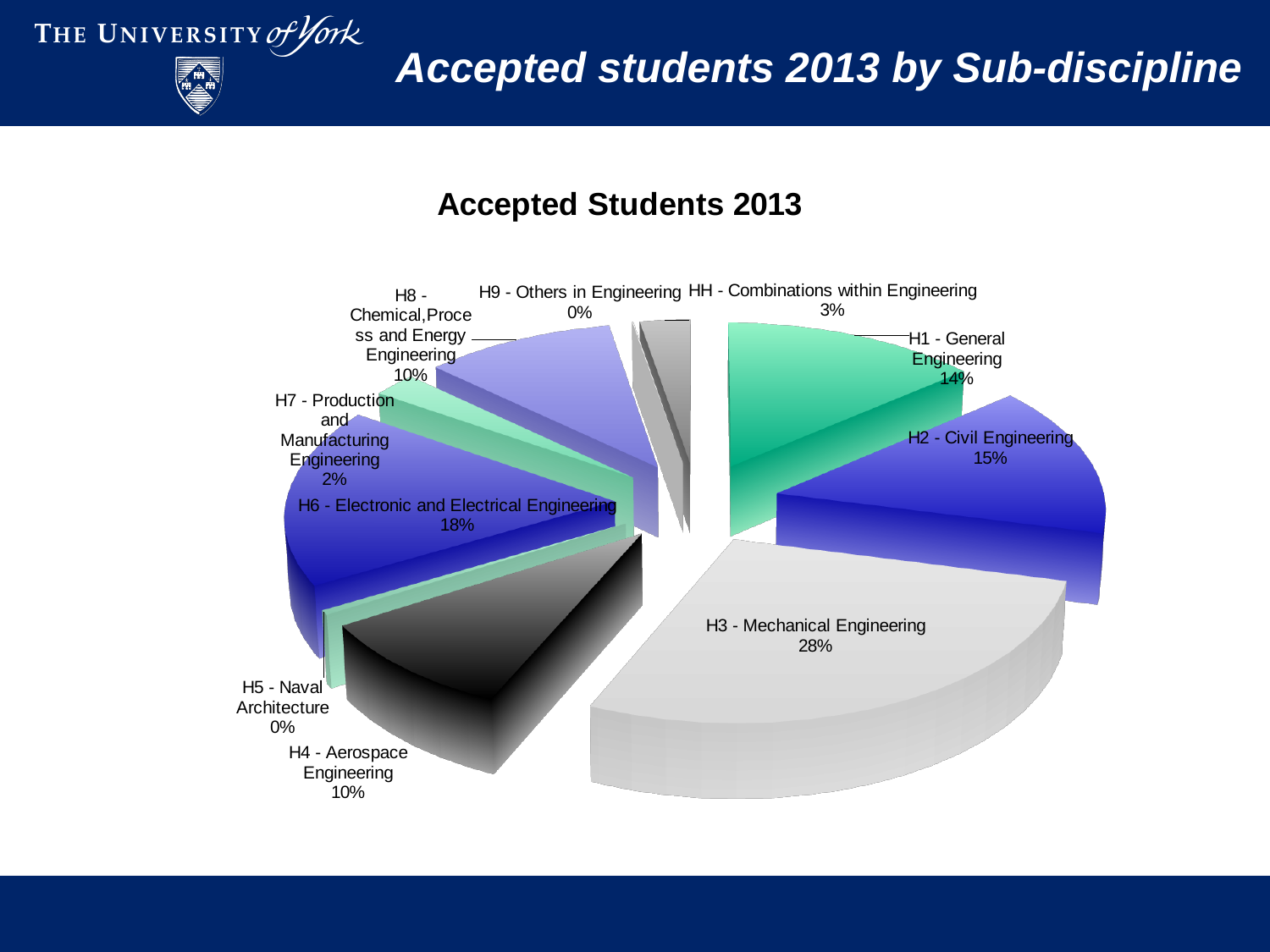
What type of chart is shown on the slide? Pie chart What is the difference in percentage points between H3 - Mechanical Engineering and H6 - Electronic and Electrical Engineering? 10 percentage points How many sub-discipline categories are shown in the pie chart? 10 What is the title of the chart? Accepted Students 2013 What share of the pie does H4 - Aerospace Engineering represent? 10% Which sub-discipline has the largest share of accepted students? H3 - Mechanical Engineering What percentage of accepted students is in H2 - Civil Engineering? 15% What percentage of accepted students is in H6 - Electronic and Electrical Engineering? 18% Which sub-disciplines have a 0% share of accepted students? H5 - Naval Architecture and H9 - Others in Engineering What percentage of accepted students is in HH - Combinations within Engineering? 3% Which has a larger share of accepted students, H1 - General Engineering or H2 - Civil Engineering? H2 - Civil Engineering What percentage of accepted students is in H3 - Mechanical Engineering? 28%